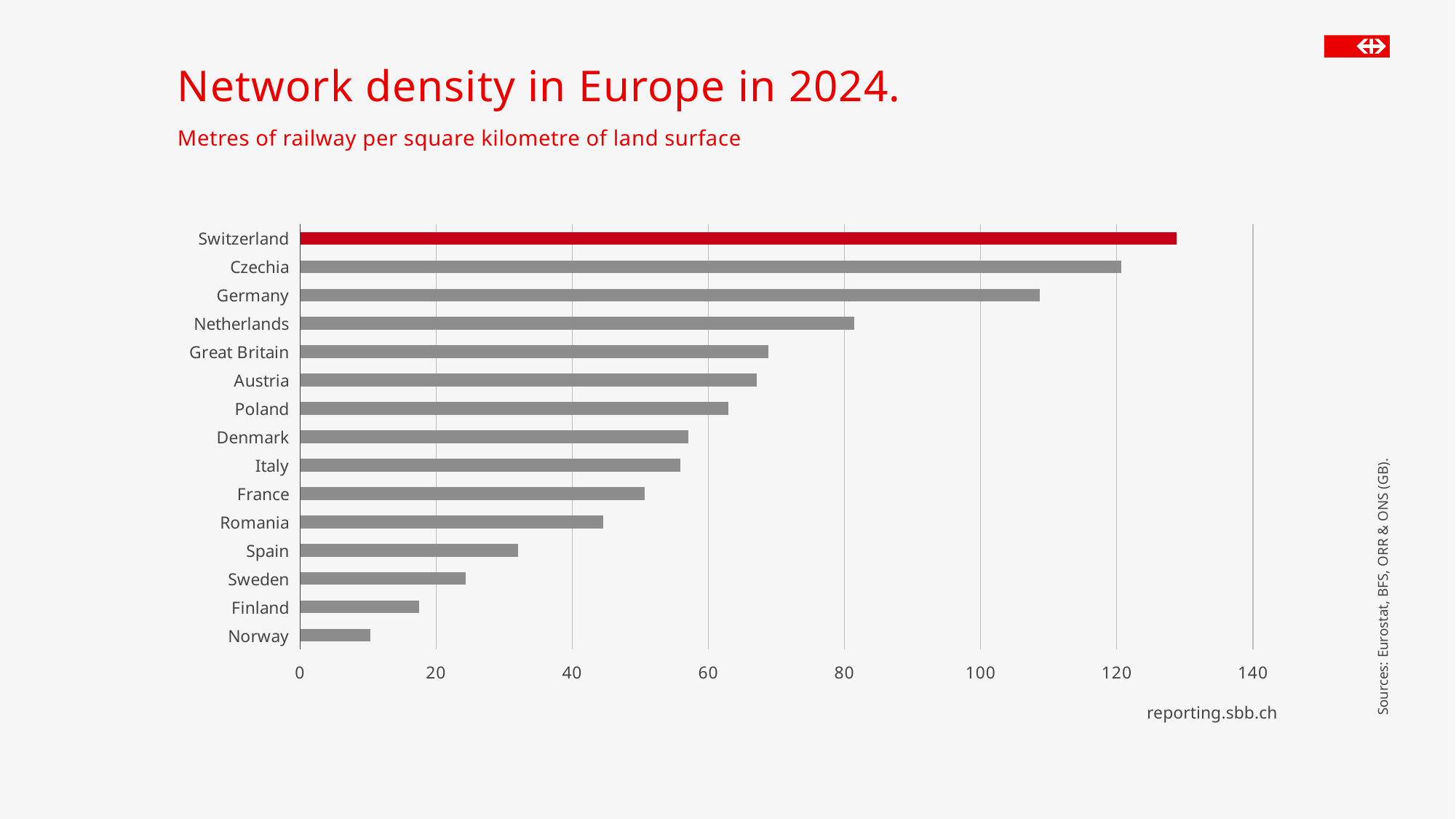
Which has a higher network density, Romania or Spain? Romania Which has a higher network density, Germany or Netherlands? Germany Is the value for Norway greater or less than 20? less Is the value for Netherlands greater or less than 100? less Which country has the lowest network density? Norway Which country has the highest network density? Switzerland Which country's bar is highlighted in red? Switzerland Is the value for Germany greater or less than 100? greater What kind of chart is shown on the slide? bar chart How many countries are shown in the chart? 15